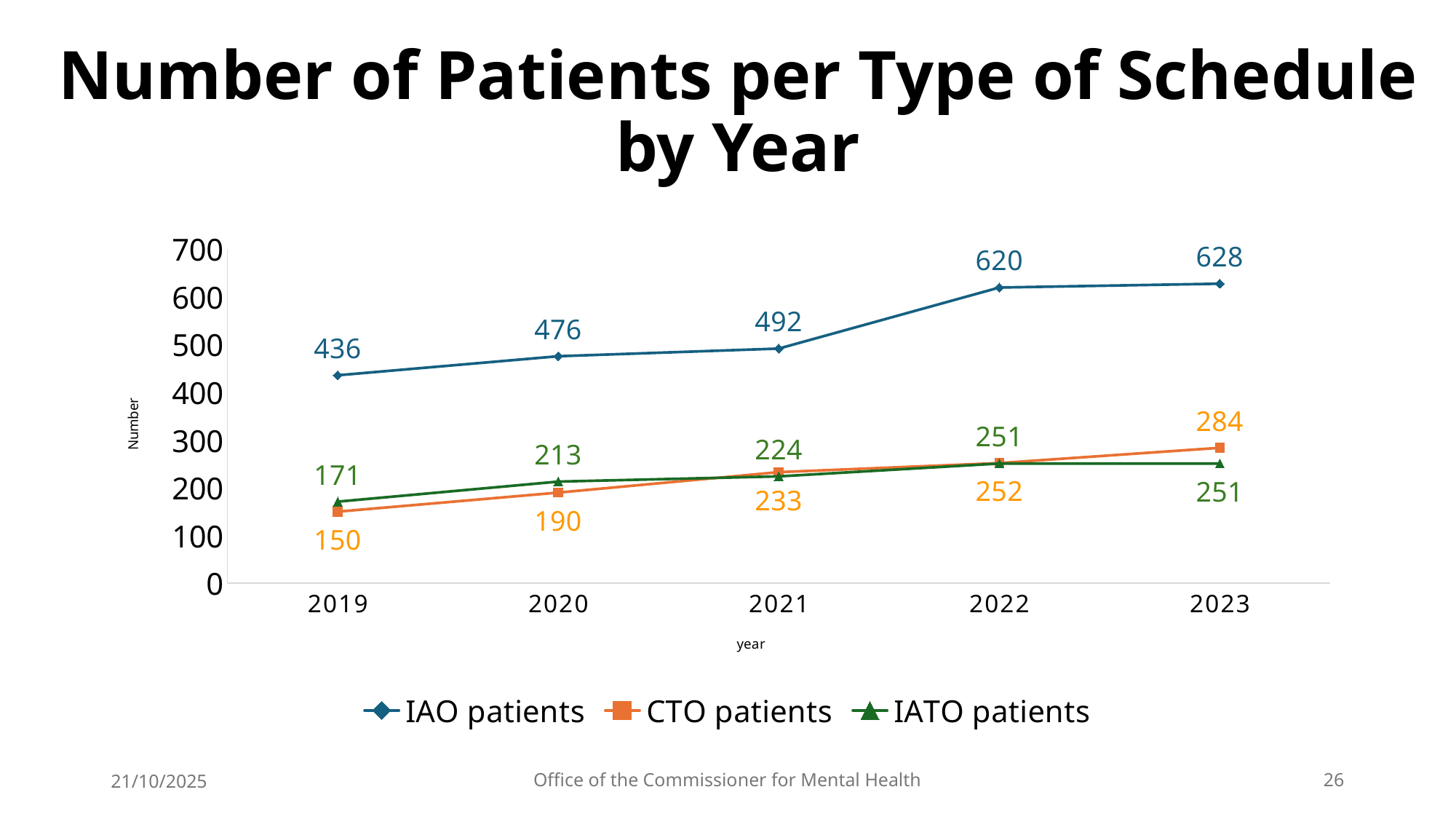
What type of chart is shown on the slide? Line chart What is the number of IATO patients in 2023? 251 How many series does the legend list? 3 In which year is the number of IAO patients highest? 2023 What is the number of CTO patients in 2020? 190 What is the difference between IAO patients in 2023 and IAO patients in 2019? 192 How many years are plotted on the x axis? 5 Which is larger in 2023, CTO patients or IATO patients? CTO patients What is the number of IAO patients in 2021? 492 What is the title of the chart's y axis? Number Do the IAO patient numbers rise or fall from 2019 to 2023? Rise In which year is the number of CTO patients lowest? 2019